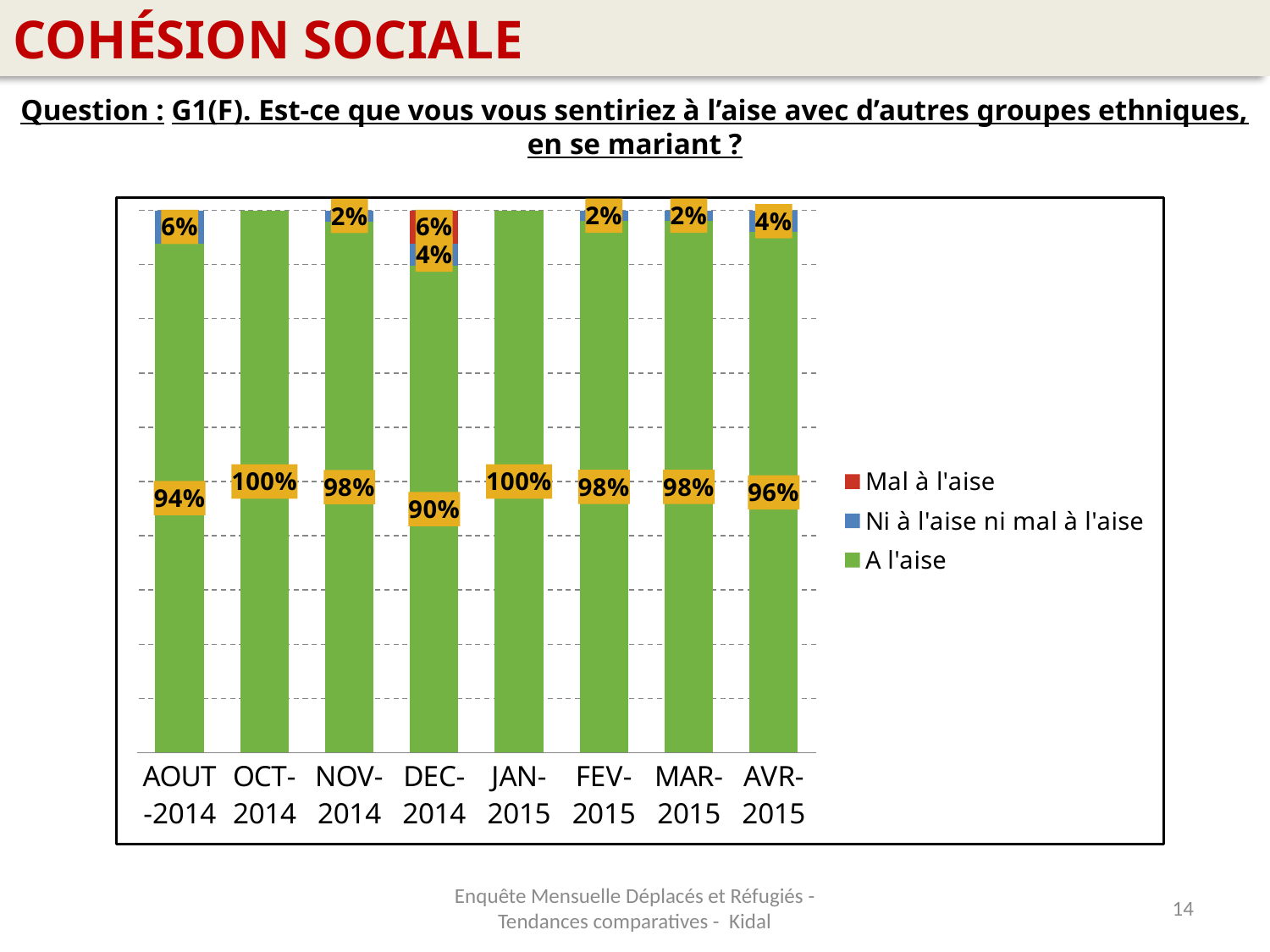
What is the value for "Ni à l'aise ni mal à l'aise" in AOUT-2014? 6% How many months are shown on the x axis? 8 Which is larger, the "A l'aise" value for NOV-2014 or for AVR-2015? NOV-2014 What is the value for "A l'aise" in AVR-2015? 96% Which colour represents "Mal à l'aise" in the legend? Red What is the value for "Mal à l'aise" in DEC-2014? 6% What is the value for "A l'aise" in DEC-2014? 90% Which month has the lowest value for "A l'aise"? DEC-2014 What is the difference between the "A l'aise" values for OCT-2014 and AOUT-2014? 6% What kind of chart is shown on the slide? Stacked bar chart In how many months does "A l'aise" reach 100%? 2 How many series does the legend list? 3